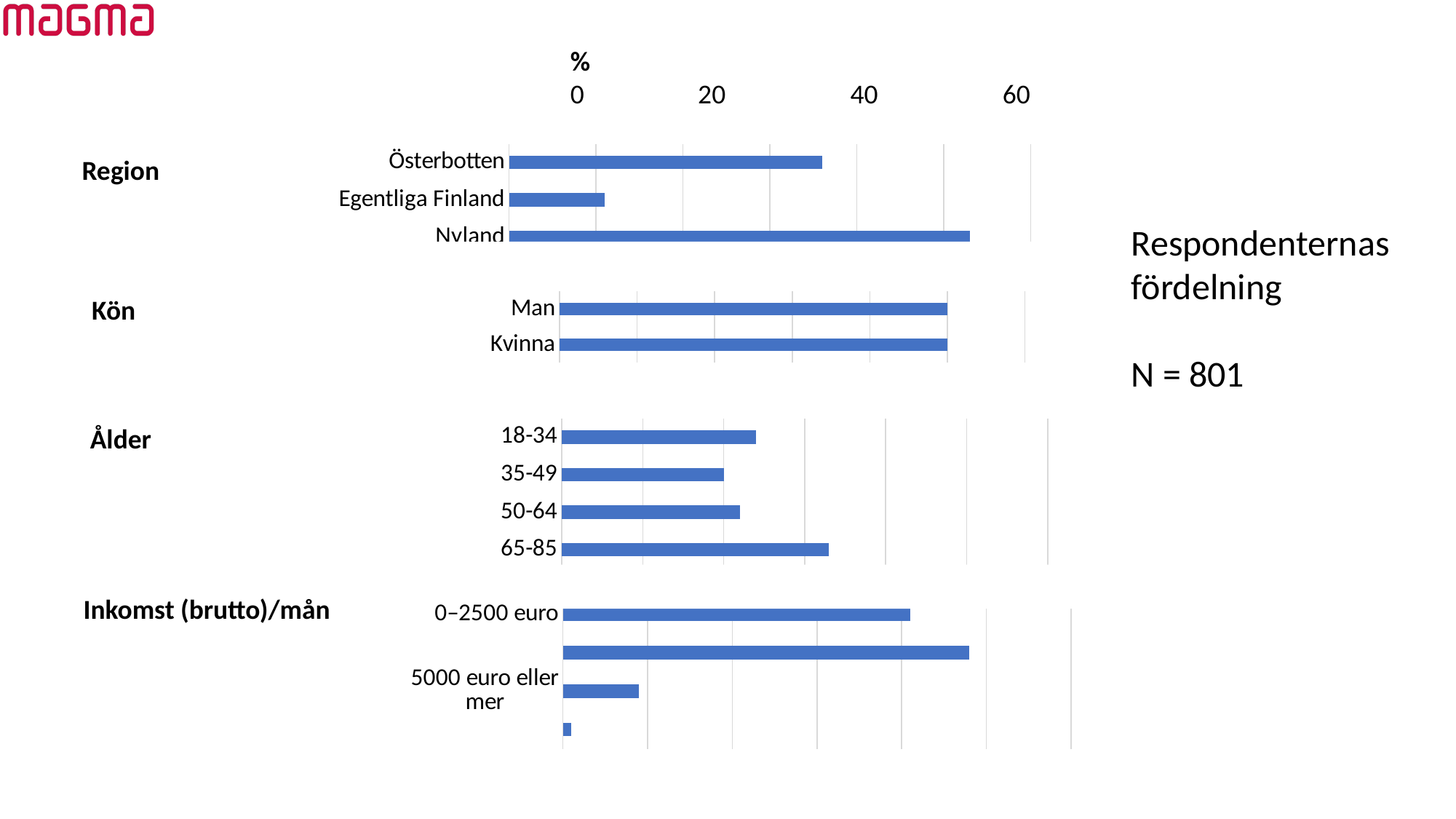
In the Region chart, is the value for Nyland greater or less than 40? greater In the Region chart, which region has the highest value? Nyland In the Region chart, which region has the lowest value? Egentliga Finland In the Region chart, which is larger, Österbotten or Egentliga Finland? Österbotten How many age groups are shown in the Ålder chart? 4 In the Inkomst (brutto)/mån chart, is the value for 5000 euro eller mer greater or less than 20? less In the Region chart, is the value for Egentliga Finland greater or less than 20? less How many categories are shown in the Region chart? 3 What is the N (number of respondents) stated on the slide? N = 801 In the Ålder chart, which age group has the highest value? 65-85 What kind of chart is used for the Region data on the slide? bar chart